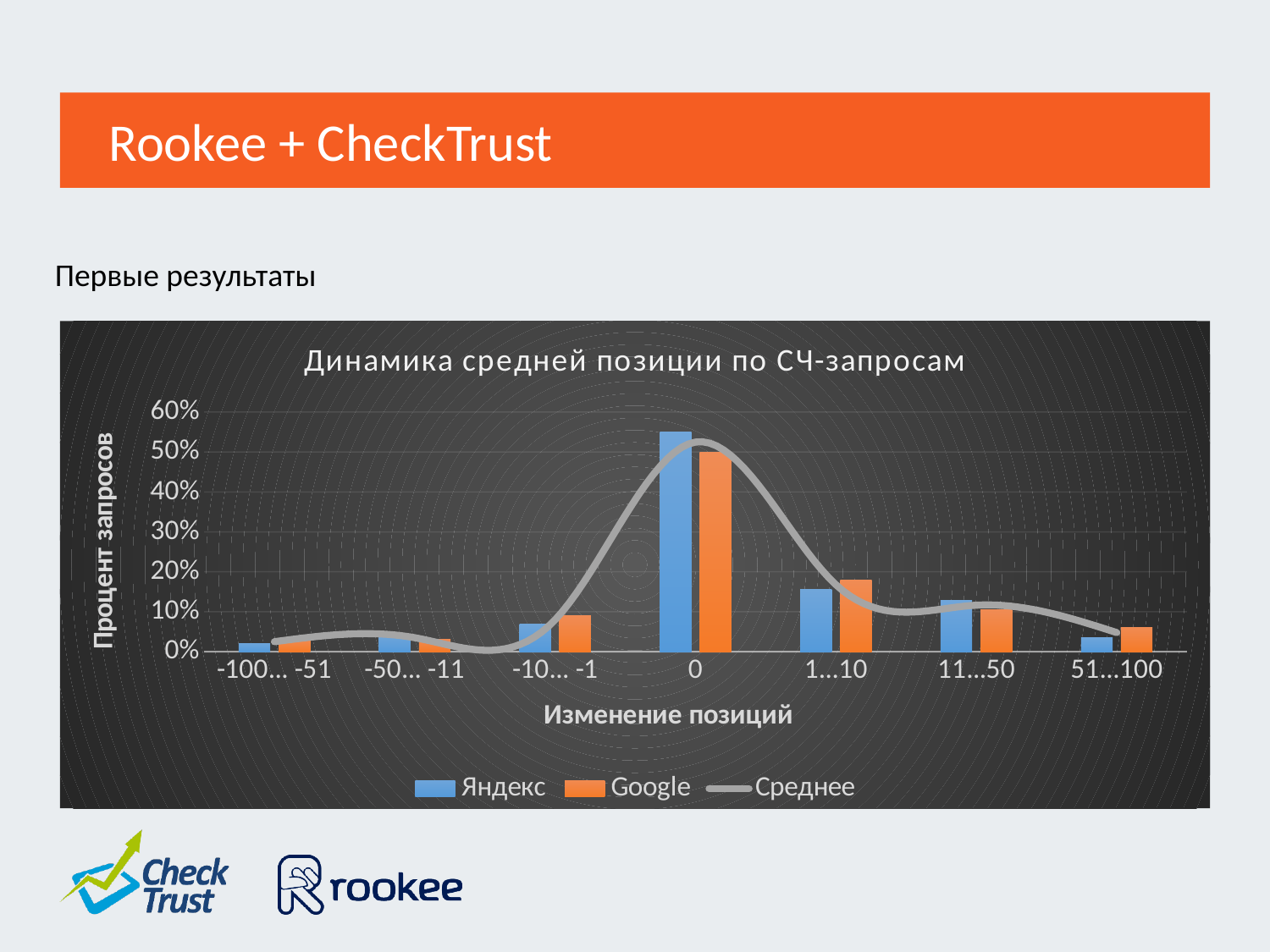
What is the title of the chart? Динамика средней позиции по СЧ-запросам How many categories are shown on the x axis? 7 What is the label of the vertical axis? Процент запросов For category 51…100, which series has the larger value, Яндекс or Google? Google How many series does the legend list? 3 For category 0, which series has the larger value, Яндекс or Google? Яндекс What kind of chart is shown on the slide? Bar chart with a line For which category is the Google bar highest? 0 Is the Яндекс value for category 0 greater or less than 50%? greater For which category is the Яндекс bar highest? 0 Is the Google value for category 1…10 greater or less than 20%? less Is the Яндекс value for category 11…50 greater or less than 10%? greater